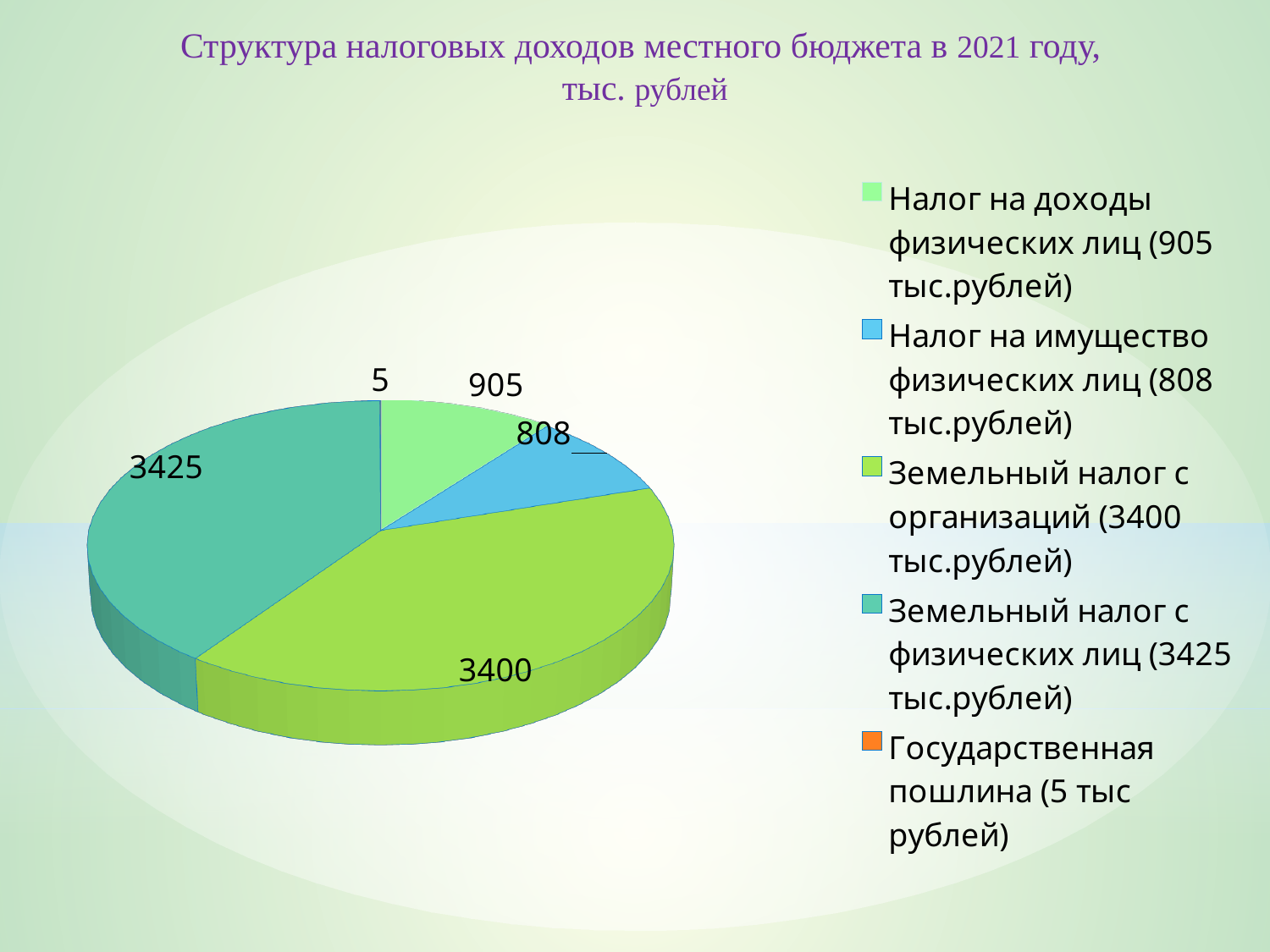
What is the value for Земельный налог с организаций? 3400 What is the value for Земельный налог с физических лиц? 3425 Which is larger: Налог на доходы физических лиц or Налог на имущество физических лиц? Налог на доходы физических лиц What is the value for Налог на имущество физических лиц? 808 How many categories does the legend list? 5 What is the value for Государственная пошлина? 5 Which category has the smallest value? Государственная пошлина What type of chart is shown on the slide? Pie chart What is the difference between Земельный налог с физических лиц and Земельный налог с организаций? 25 What is the title of the chart? Структура налоговых доходов местного бюджета в 2021 году, тыс. рублей Which category has the largest value? Земельный налог с физических лиц What is the value for Налог на доходы физических лиц? 905